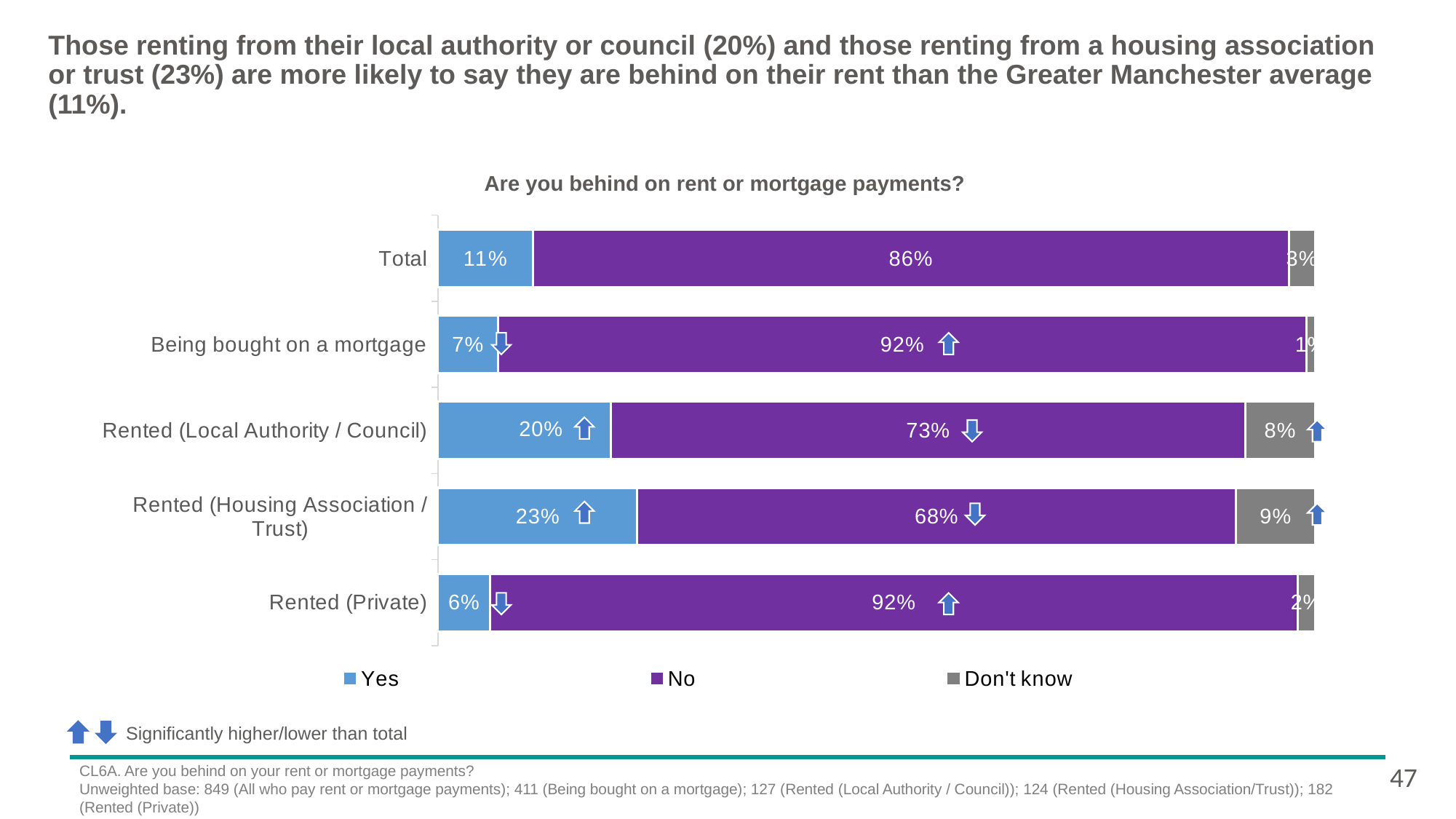
What type of chart is shown on the slide? Stacked bar chart Which category has the highest Yes value? Rented (Housing Association / Trust) How many series does the legend list? 3 What percentage of those in the Rented (Housing Association / Trust) group answered No? 68% How many categories are shown on the chart? 5 Which category has the lowest Yes value? Rented (Private) What is the Yes value for the Total category? 11% What is the title of the chart? Are you behind on rent or mortgage payments? What percentage of those in the Rented (Local Authority / Council) group answered Yes? 20% What is the Don't know value for Rented (Local Authority / Council)? 8% Which has a larger No value: Being bought on a mortgage or Rented (Local Authority / Council)? Being bought on a mortgage How many percentage points higher is the Yes value for Rented (Housing Association / Trust) than for Total? 12 percentage points